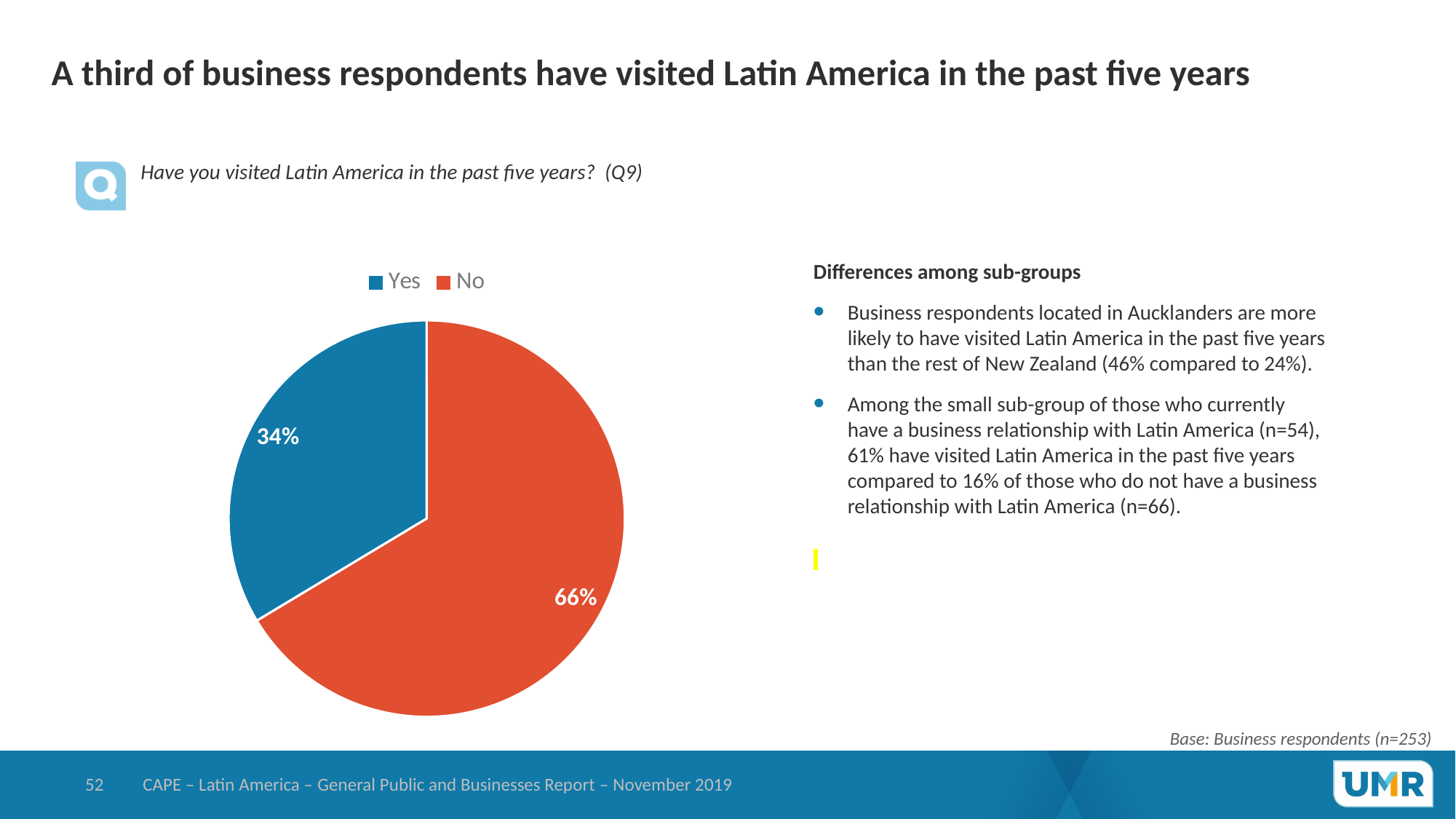
What colour is the "Yes" slice of the pie chart? Blue How many entries does the legend list? 2 What is the difference in percentage points between the No and Yes slices? 32 Is the share for "Yes" greater or less than 50%? less How many categories does the pie chart show? 2 What percentage of business respondents answered "No"? 66% Which response has the larger share of the pie, Yes or No? No What kind of chart is shown on the slide? Pie chart Which category has the largest slice in the pie chart? No What colour is the "No" slice of the pie chart? Red Which category has the smallest slice in the pie chart? Yes What percentage of business respondents answered "Yes" to having visited Latin America in the past five years? 34%